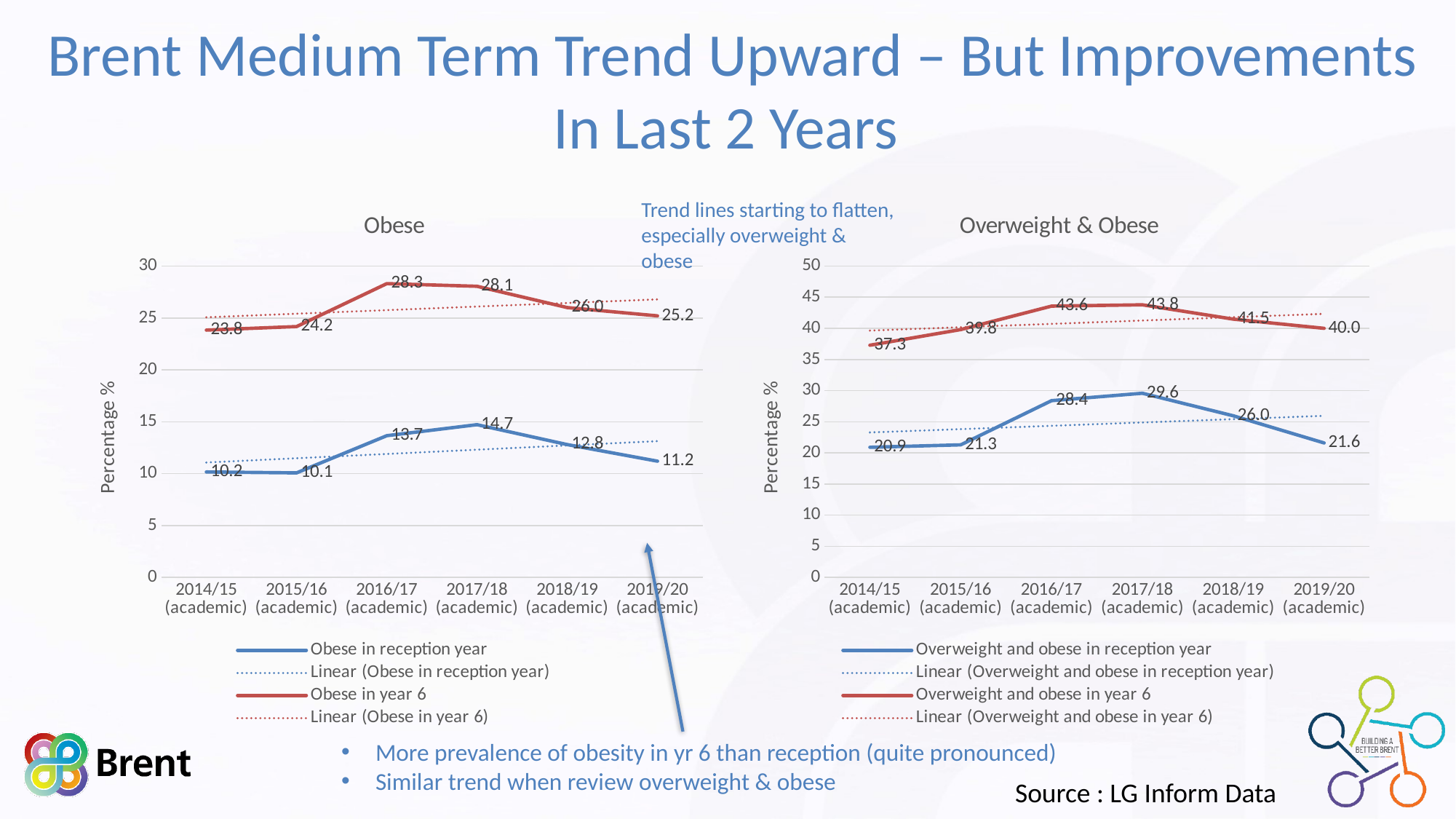
In the Overweight & Obese chart, how many academic years are shown on the x axis? 6 How many entries does the legend of the Obese chart list? 4 In the Obese chart, in which academic year is Obese in year 6 lowest? 2014/15 (academic) In the Overweight & Obese chart, what is the value for Overweight and obese in reception year in 2017/18 (academic)? 29.6 In the Obese chart, what is the value for Obese in year 6 in 2016/17 (academic)? 28.3 In the Overweight & Obese chart, what is the value for Overweight and obese in year 6 in 2014/15 (academic)? 37.3 In the Overweight & Obese chart, which is larger: Overweight and obese in reception year in 2016/17 (academic) or in 2019/20 (academic)? 2016/17 (academic) What type of chart is the Overweight & Obese chart? Line chart In the Obese chart, what is the difference between Obese in year 6 and Obese in reception year in 2017/18 (academic)? 13.4 In the Overweight & Obese chart, in which academic year is Overweight and obese in year 6 highest? 2017/18 (academic) In the Obese chart, what is the value for Obese in reception year in 2019/20 (academic)? 11.2 In the Obese chart, in which academic year is Obese in reception year highest? 2017/18 (academic)